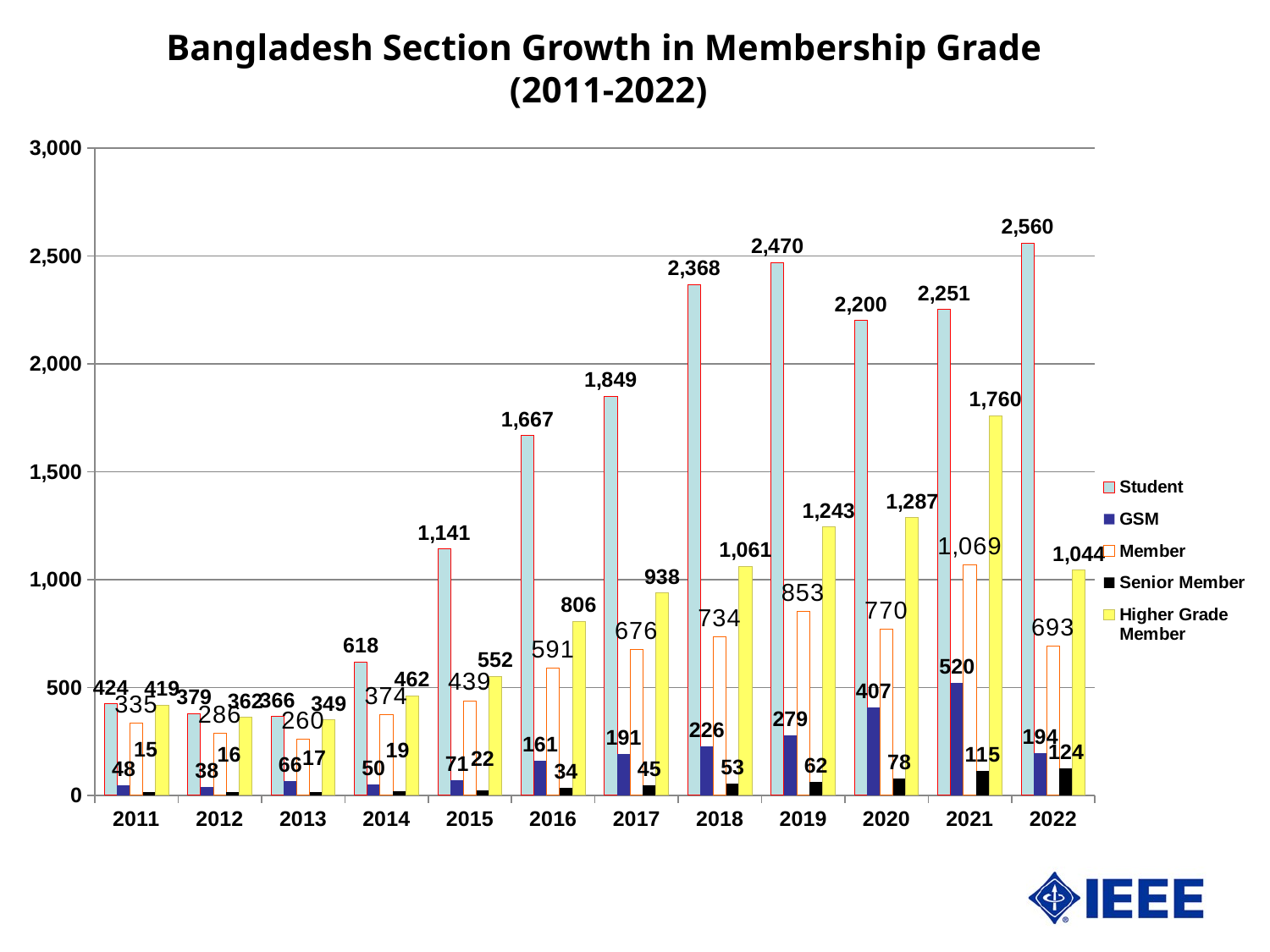
In which year is the Member value lowest? 2013 Does the Senior Member value rise or fall from 2011 to 2022? Rise What is the difference between the Student values for 2019 and 2018? 102 What kind of chart is this? Bar chart What is the GSM value for 2020? 407 Which is larger, the Member value for 2021 or the Higher Grade Member value for 2022? Member value for 2021 What is the Senior Member value for 2011? 15 What is the Student value for 2022? 2,560 What is the Higher Grade Member value for 2021? 1,760 How many series does the legend list? 5 How many years are shown on the x axis? 12 In which year is the Student value highest? 2022